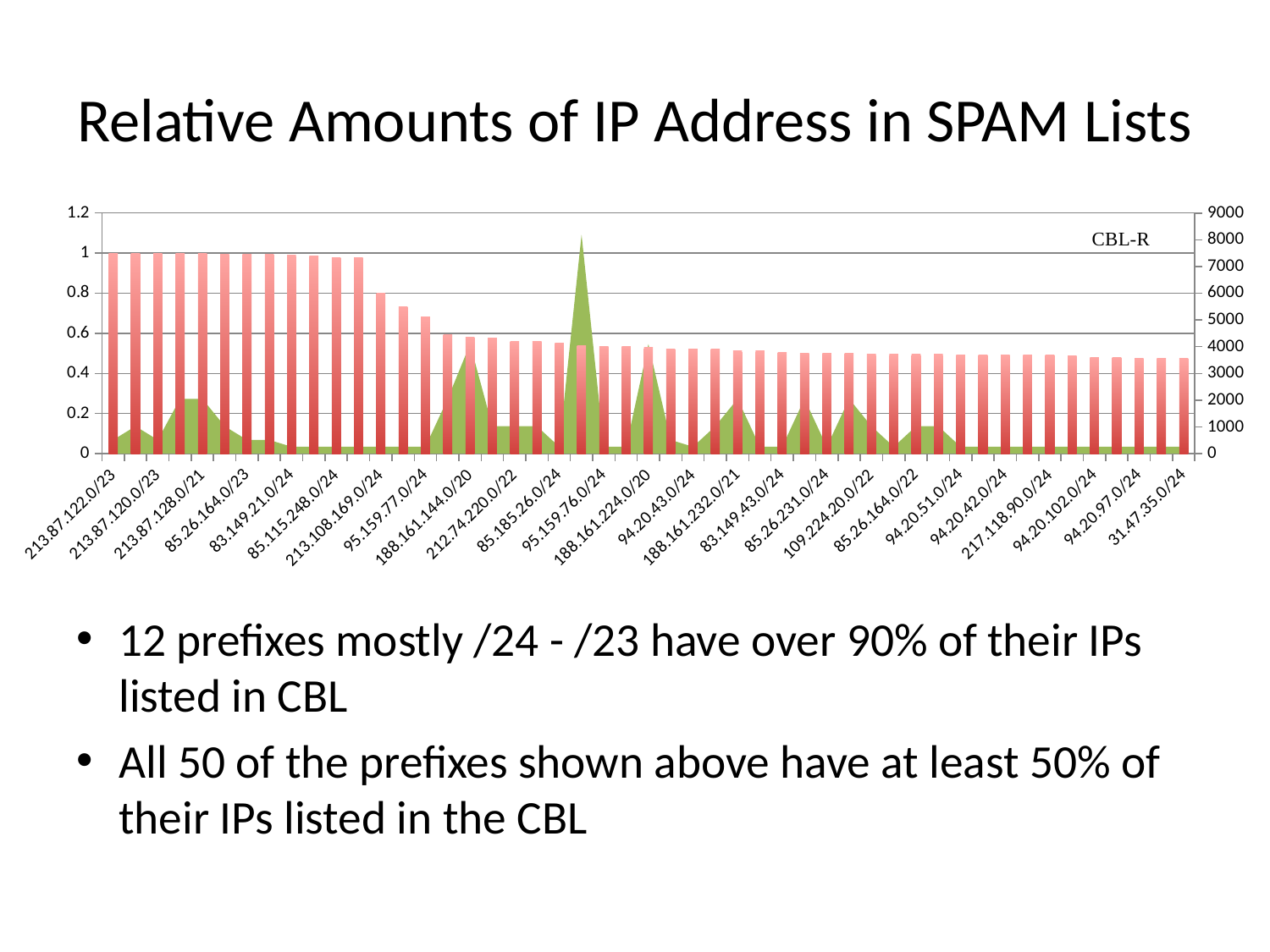
What is the title of the chart? Relative Amounts of IP Address in SPAM Lists What is the only entry shown in the chart's legend? CBL-R Which has the larger red bar value, 213.87.122.0/23 or 31.47.35.0/24? 213.87.122.0/23 Is the red bar value for 95.159.77.0/24 greater or less than 0.4 on the left axis? greater Do the red bar values rise or fall moving from left to right along the x axis? fall Is the red bar value for 213.87.122.0/23 greater or less than 0.8 on the left axis? greater How many prefixes are plotted as bars in the chart? 49 What kind of chart is used for the red series? bar chart Is the red bar value for 31.47.35.0/24 greater or less than 0.6 on the left axis? less What is the maximum value shown on the right-hand vertical axis? 9000